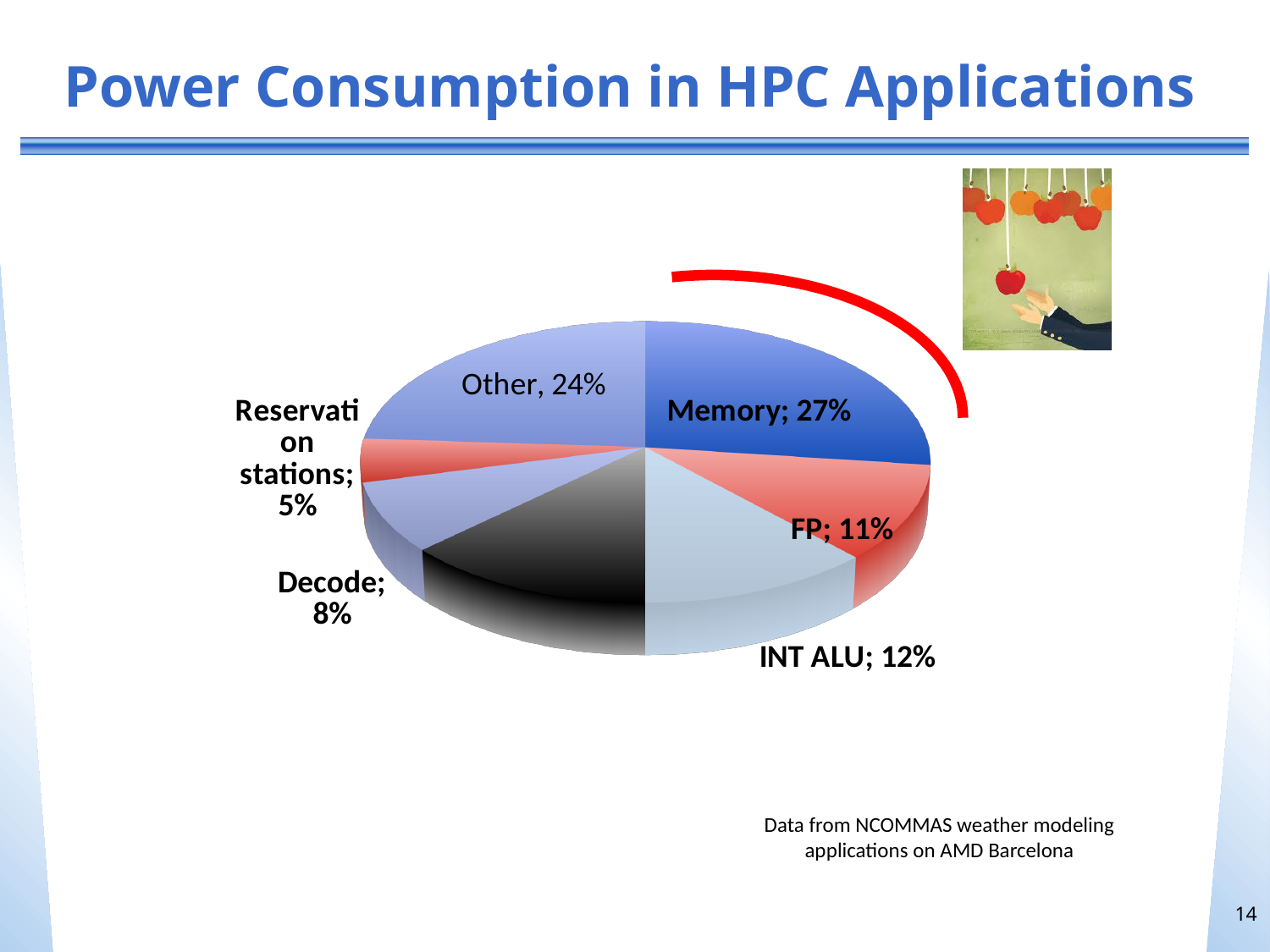
What percentage of power consumption is attributed to Memory? 27% What share of the pie does INT ALU account for? 12% Which is larger, the share for INT ALU or the share for FP? INT ALU What is the value for Reservation stations? 5% What is the title of the slide containing the chart? Power Consumption in HPC Applications What type of chart is shown on the slide? Pie chart What is the value shown for the FP slice? 11% Which labeled category has the largest share of the pie? Memory Which labeled category has the smallest share of the pie? Reservation stations What is the difference in percentage points between Memory and Other? 3% What share of the pie is labeled Other? 24% What percentage is shown for Decode? 8%